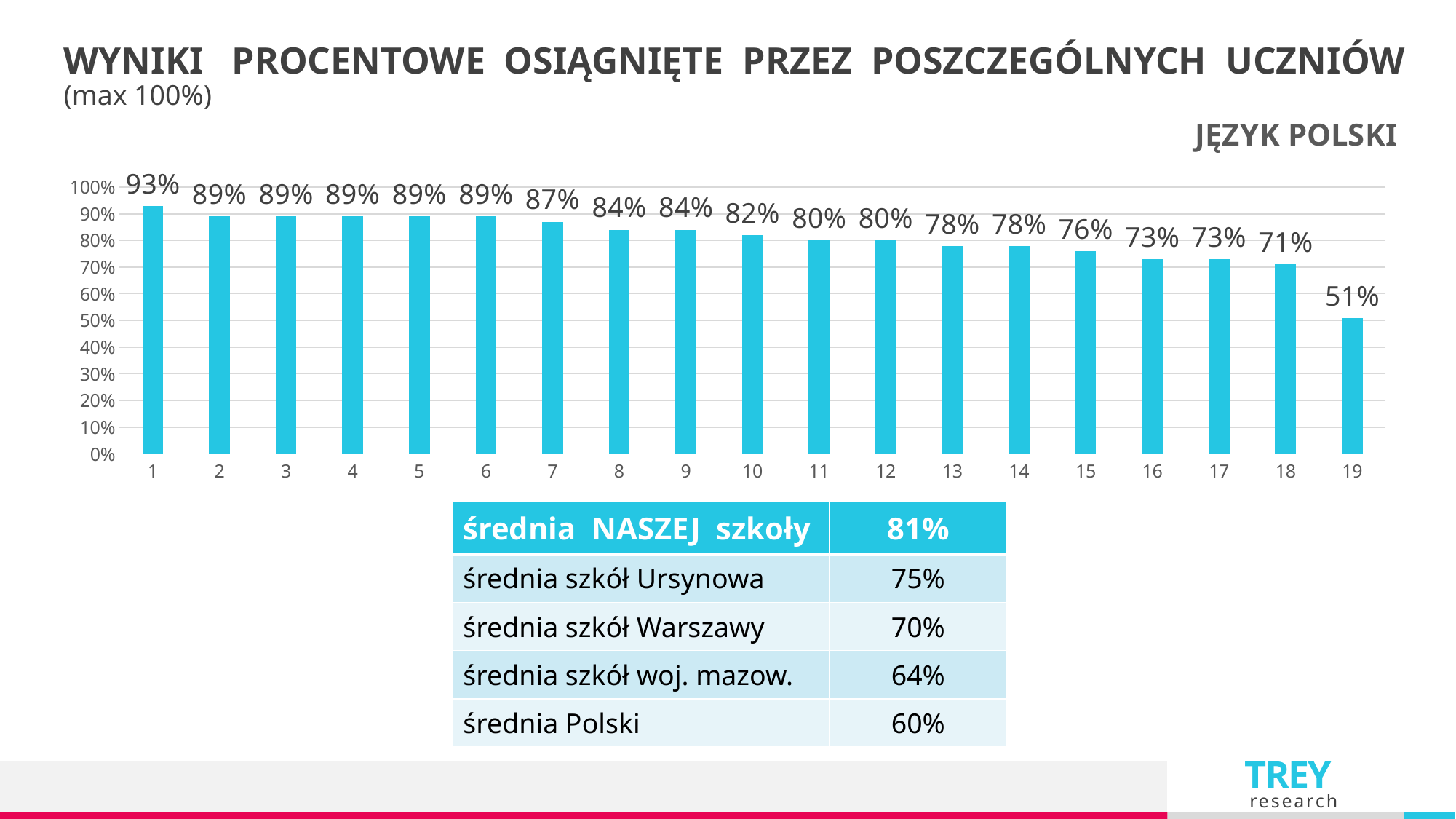
Do the values rise or fall from student 1 to student 19? fall Which student has the highest result? 1 What is the value for student 10? 82% How many students are shown on the x axis? 19 What kind of chart is shown on the slide? bar chart Which student has the lowest result? 19 Which is larger, the value for student 13 or the value for student 18? student 13 What is the value for student 1? 93% Is the value for student 16 greater or less than 80%? less What is the value for student 19? 51% What is the difference between the values for student 7 and student 15? 11% What is the difference between the values for student 1 and student 19? 42%